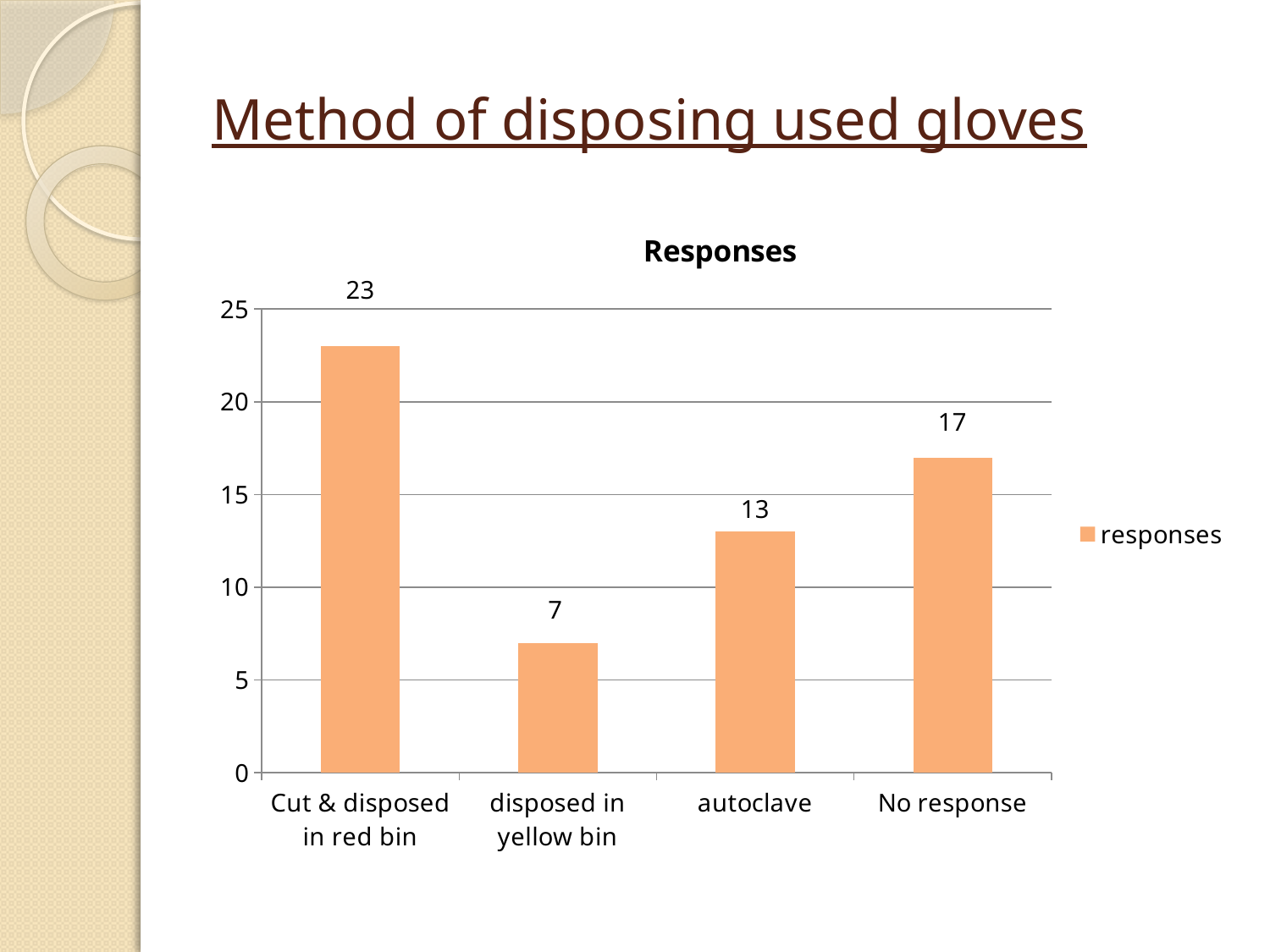
What is the difference in responses between 'Cut & disposed in red bin' and 'No response'? 6 What is the number of responses for 'No response'? 17 What is the number of responses for 'disposed in yellow bin'? 7 Which category has the highest number of responses? Cut & disposed in red bin What type of chart is shown on the slide? Bar chart Which has more responses, 'autoclave' or 'No response'? No response Is the value for 'autoclave' greater or less than 15? less What is the title of the chart? Responses What is the number of responses for 'Cut & disposed in red bin'? 23 How many categories are shown on the x axis? 4 Which category has the lowest number of responses? disposed in yellow bin What is the number of responses for 'autoclave'? 13